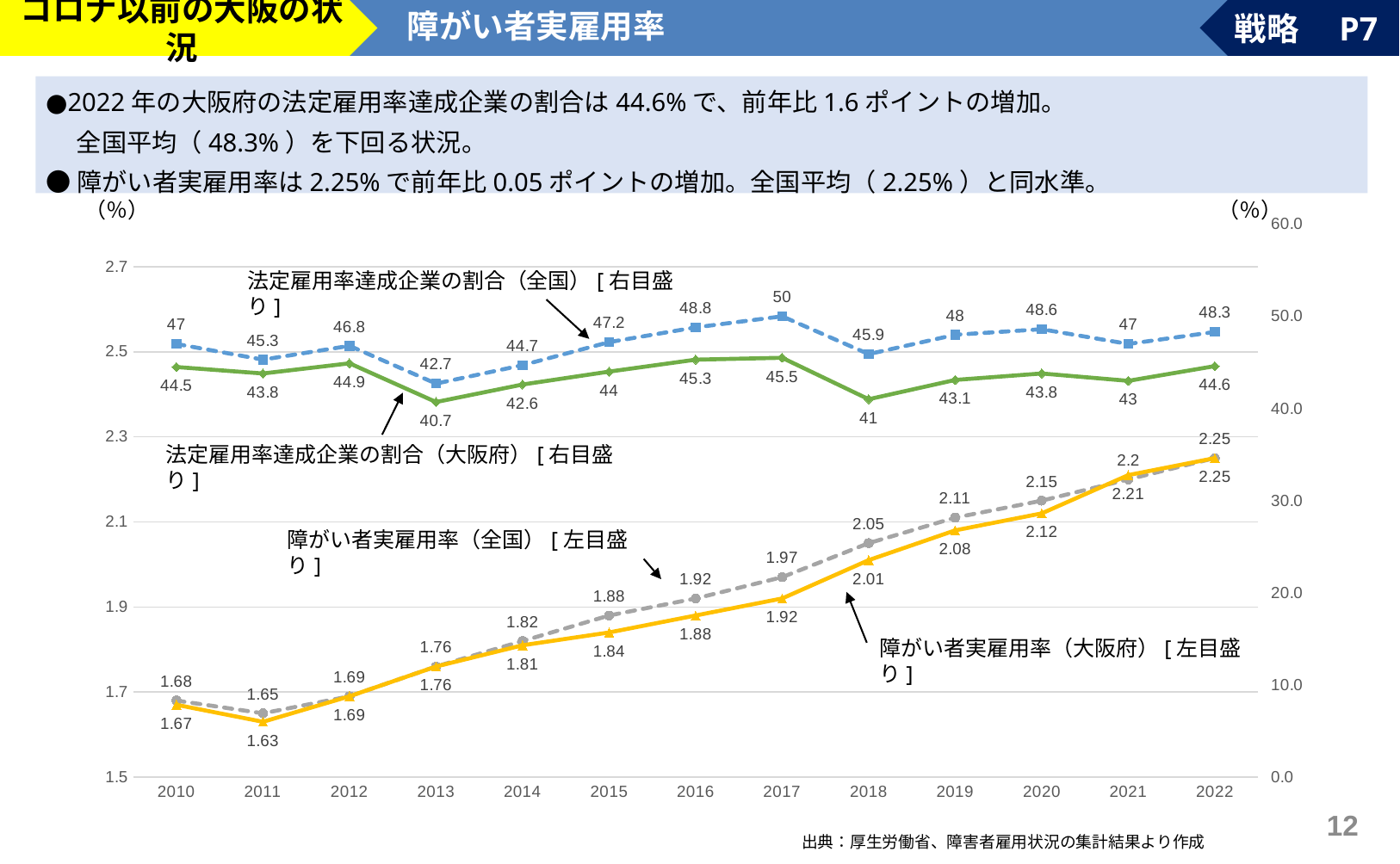
How many years are plotted along the x axis of the chart? 13 What is the value of 法定雇用率達成企業の割合（全国） in 2017? 50 What is the value of 法定雇用率達成企業の割合（大阪府） in 2013? 40.7 What is the difference between 法定雇用率達成企業の割合（全国） and 法定雇用率達成企業の割合（大阪府） in 2022? 3.7 What is the value of 障がい者実雇用率（全国） in 2011? 1.65 Which is larger in 2018: 障がい者実雇用率（全国） or 障がい者実雇用率（大阪府）? 障がい者実雇用率（全国） In which year is 障がい者実雇用率（大阪府） lowest? 2011 Which series is plotted with a dashed blue line? 法定雇用率達成企業の割合（全国）[右目盛り] What is the value of 障がい者実雇用率（大阪府） in 2022? 2.25 What kind of chart is shown on the slide? line chart Does 障がい者実雇用率（大阪府） rise or fall from 2012 to 2022? rise In which year is 法定雇用率達成企業の割合（全国） highest? 2017